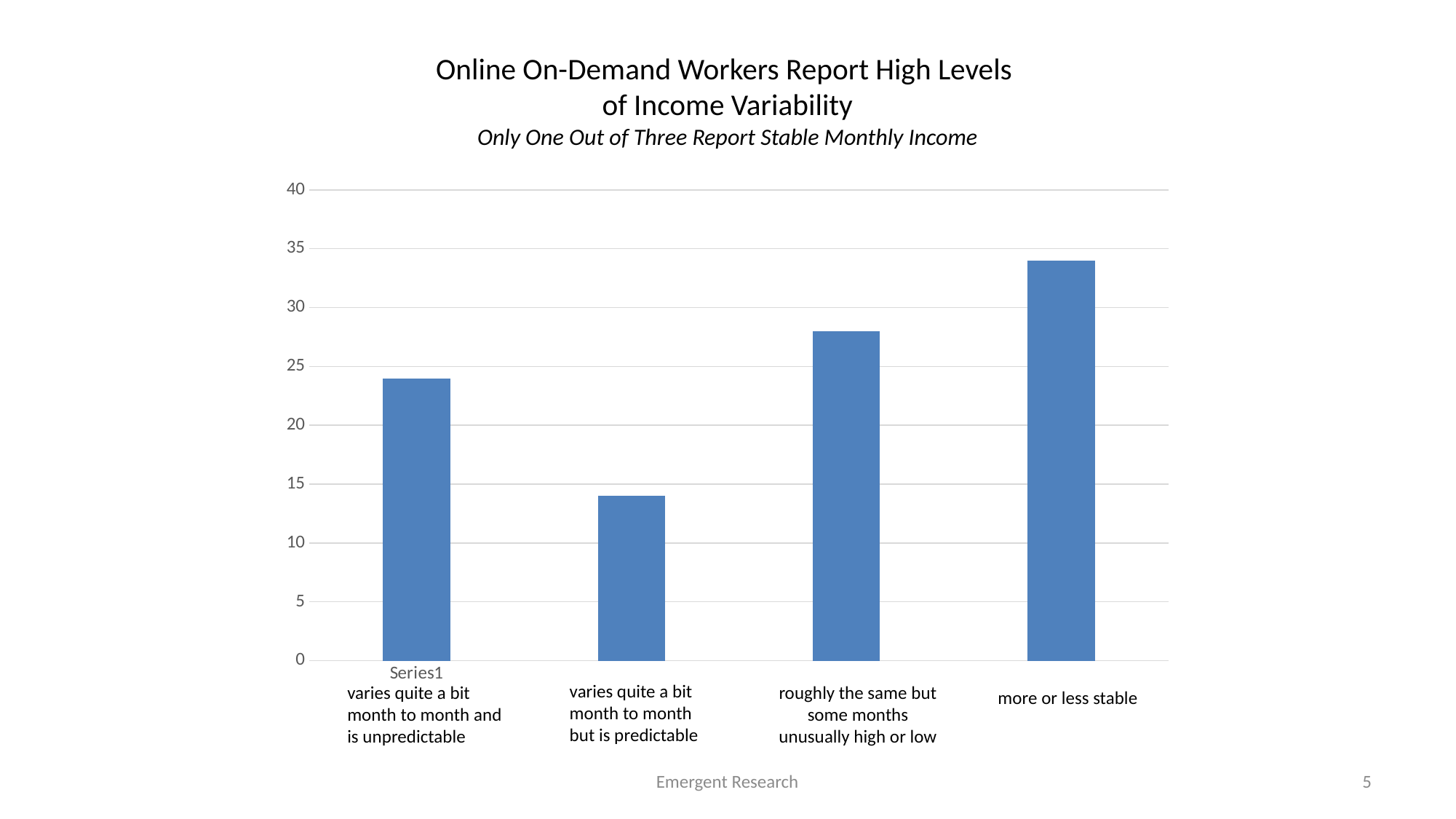
Is the value for "roughly the same but some months unusually high or low" greater or less than 25? greater Which category has the highest bar? more or less stable Which category has the lowest bar? varies quite a bit month to month but is predictable Is the value for "varies quite a bit month to month and is unpredictable" greater or less than 20? greater Is the value for "more or less stable" greater or less than 30? greater Which is larger: the value for "varies quite a bit month to month and is unpredictable" or the value for "roughly the same but some months unusually high or low"? roughly the same but some months unusually high or low What is the italic subtitle shown under the chart title? Only One Out of Three Report Stable Monthly Income How many categories (bars) does the chart show? 4 What kind of chart is shown on the slide? bar chart What is the main title of the chart? Online On-Demand Workers Report High Levels of Income Variability